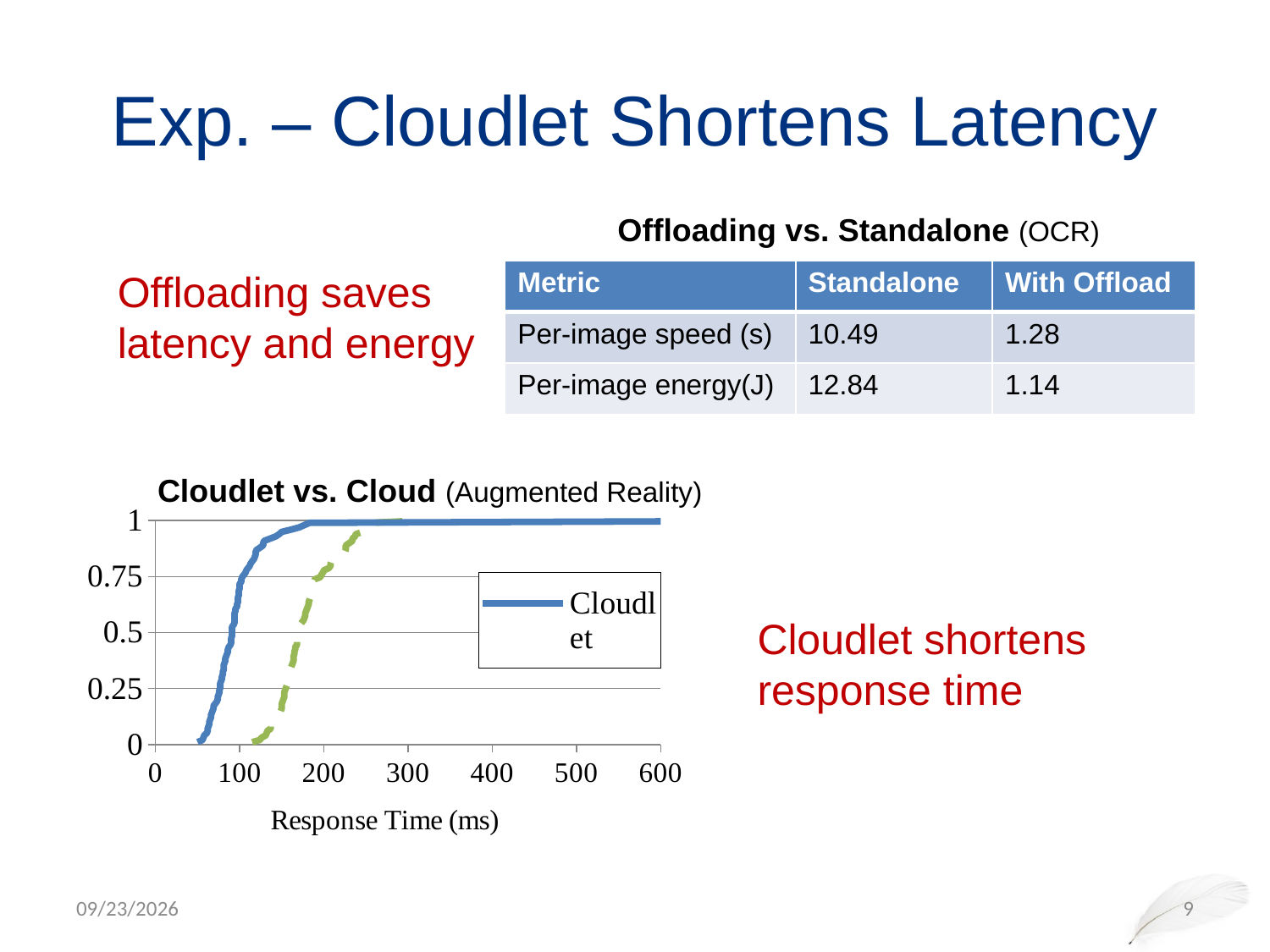
What is the x-axis label of the "Cloudlet vs. Cloud (Augmented Reality)" chart? Response Time (ms) In the "Cloudlet vs. Cloud" chart, is the value of the dashed line at 200 ms greater or less than 0.5? greater What kind of chart is the "Cloudlet vs. Cloud (Augmented Reality)" chart? line chart How many series entries are readable in the legend of the "Cloudlet vs. Cloud" chart? 1 In the "Cloudlet vs. Cloud" chart, which line reaches the value 1 at a lower response time, the solid Cloudlet line or the dashed line? the solid Cloudlet line In the "Cloudlet vs. Cloud" chart, is the value of the solid Cloudlet line at 150 ms greater or less than 0.5? greater In the "Cloudlet vs. Cloud" chart, which line is higher at 150 ms, the solid Cloudlet line or the dashed line? the solid Cloudlet line In the "Cloudlet vs. Cloud" chart, do the plotted lines rise or fall as response time increases? rise How many lines are plotted in the "Cloudlet vs. Cloud" chart? 2 In the "Cloudlet vs. Cloud" chart, is the value of the dashed line at 100 ms greater or less than 0.25? less What is the highest tick value shown on the x axis of the "Cloudlet vs. Cloud" chart? 600